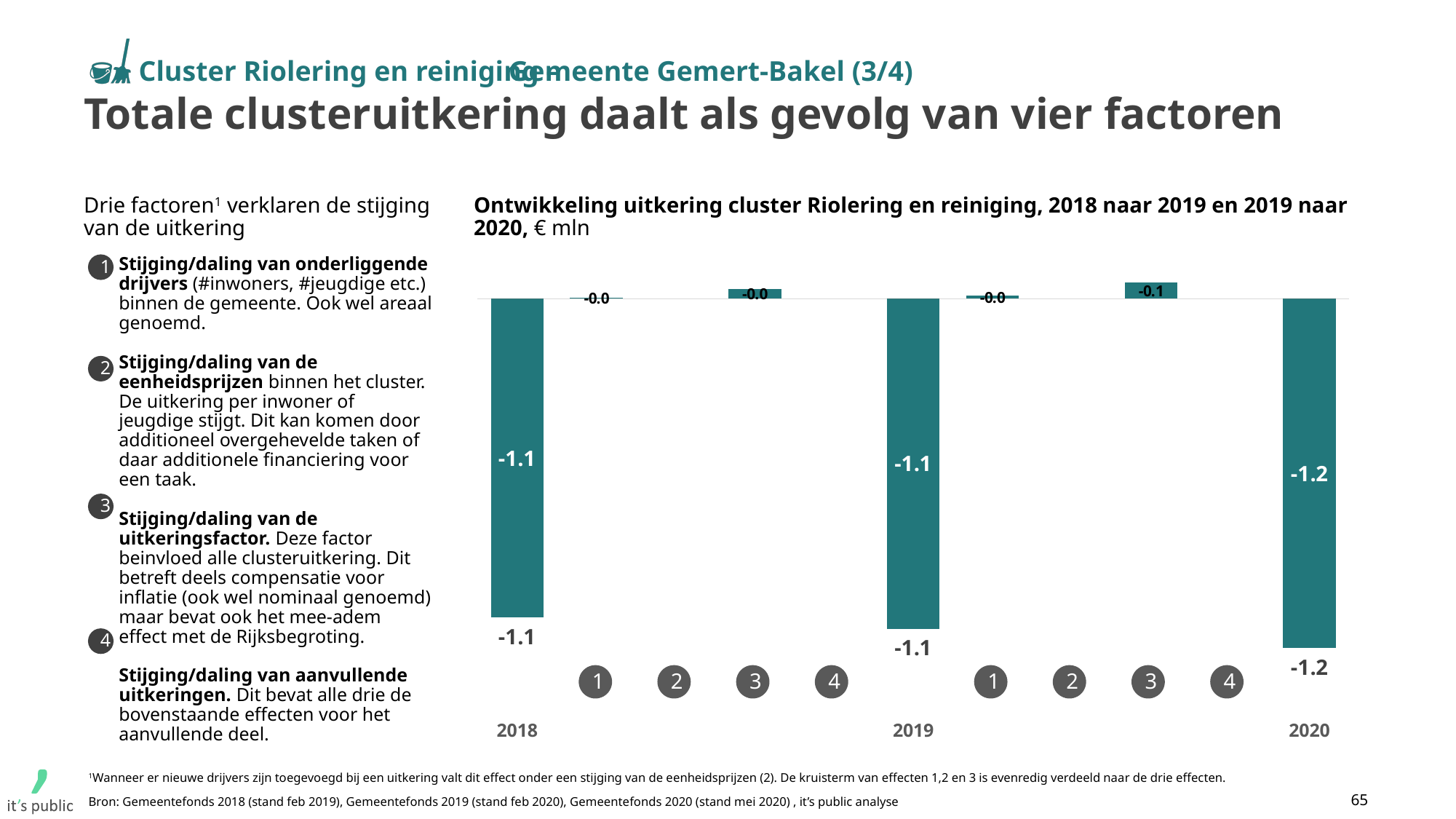
Does the total uitkering rise or fall from 2018 to 2020 in the chart? fall Which year has the lowest (most negative) total uitkering in the chart? 2020 What is the value of the 2019 bar in the chart? -1.1 What is the title of the chart? Ontwikkeling uitkering cluster Riolering en reiniging, 2018 naar 2019 en 2019 naar 2020, € mln What unit is the chart expressed in, according to its title? € mln Is the 2020 value lower or higher than the 2019 value in the chart? lower What is the value of the 2018 bar in the chart? -1.1 What is the difference between the 2020 value and the 2018 value in the chart? 0.1 What is the value of the 2020 bar in the chart? -1.2 How many year totals (2018, 2019, 2020) are shown as large bars in the chart? 3 What kind of chart is shown on the slide? bar chart What is the value labelled for factor 3 between 2019 and 2020 in the chart? -0.1